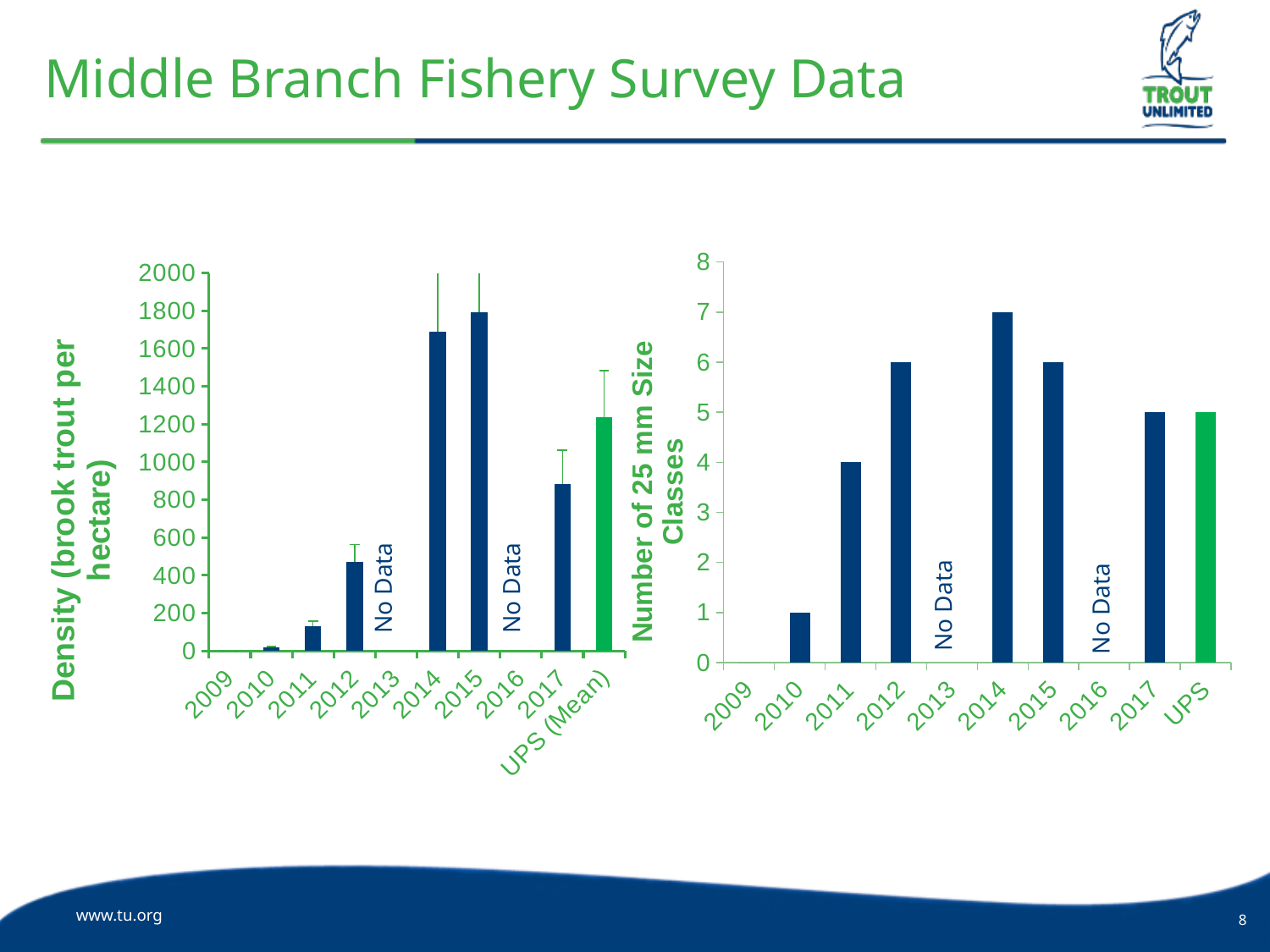
In the left chart (Density), is the value for 2015 greater or less than 1600? greater In the right chart (Number of 25 mm Size Classes), which year has the highest number of size classes? 2014 In the left chart (Density), which is larger, the value for 2014 or the value for 2017? 2014 In the right chart (Number of 25 mm Size Classes), which is larger, the value for 2012 or the value for 2017? 2012 In the right chart (Number of 25 mm Size Classes), what is the difference between the values for 2014 and 2010? 6 In the right chart (Number of 25 mm Size Classes), what is the value for 2011? 4 What kind of chart is the left chart (Density)? bar chart In the right chart (Number of 25 mm Size Classes), what is the value for UPS? 5 In the left chart (Density), which years are marked "No Data"? 2013 and 2016 In the left chart (Density), is the value for 2012 greater or less than 600? less In the right chart (Number of 25 mm Size Classes), what is the value for 2014? 7 In the left chart (Density), is the value for UPS (Mean) greater or less than 1000? greater